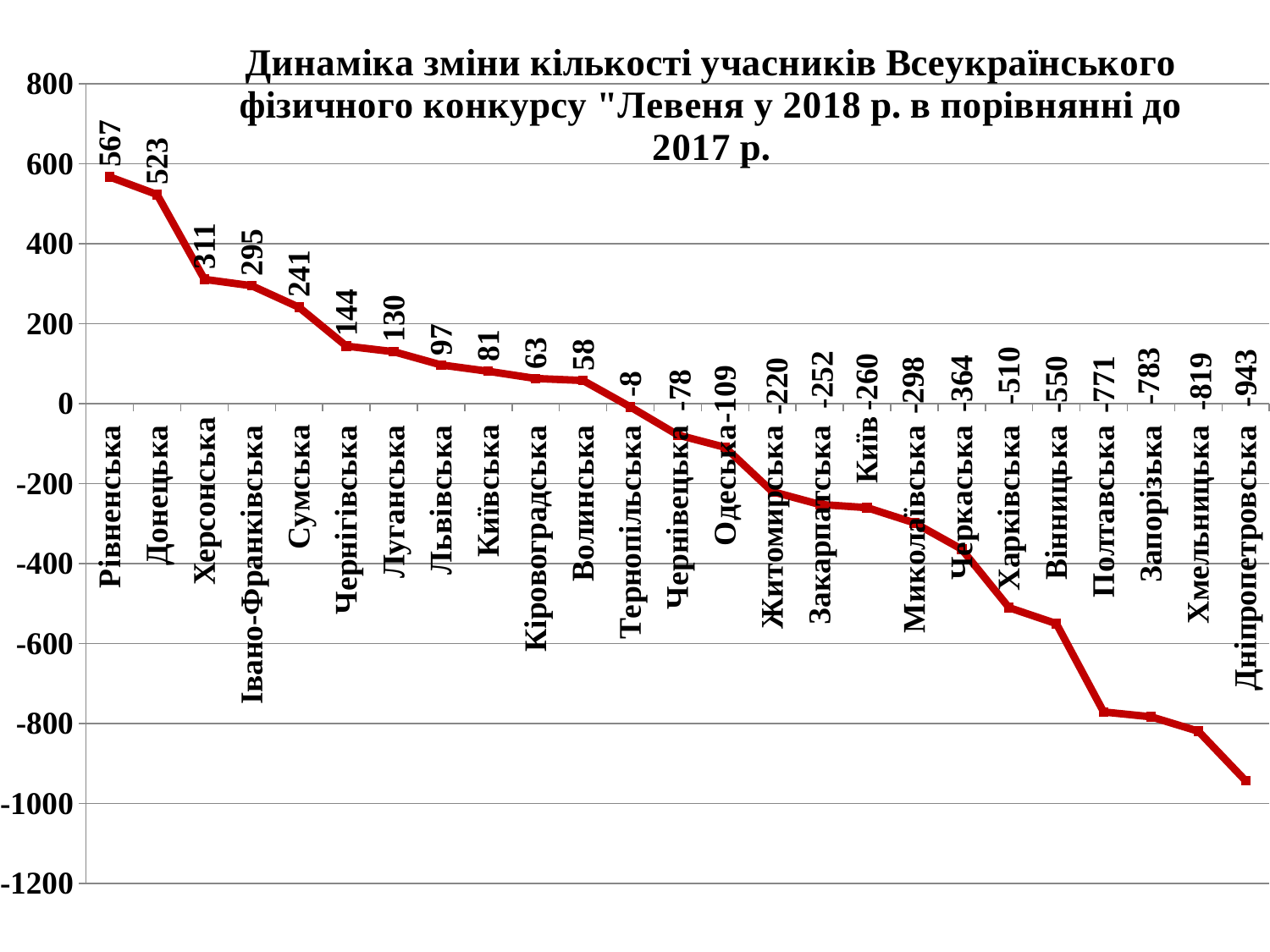
Which category has the highest value? Рівненська What kind of chart is shown on the slide? line chart What is the value for Рівненська? 567 Do the values rise or fall from left to right along the x axis? fall Which category has the lowest value? Дніпропетровська What is the value for Тернопільська? -8 Is the value for Харківська greater or less than -400? less What is the value for Київ? -260 What is the difference between the values for Рівненська and Донецька? 44 What is the value for Дніпропетровська? -943 Which has a larger value, Херсонська or Сумська? Херсонська How many categories are plotted on the chart? 25